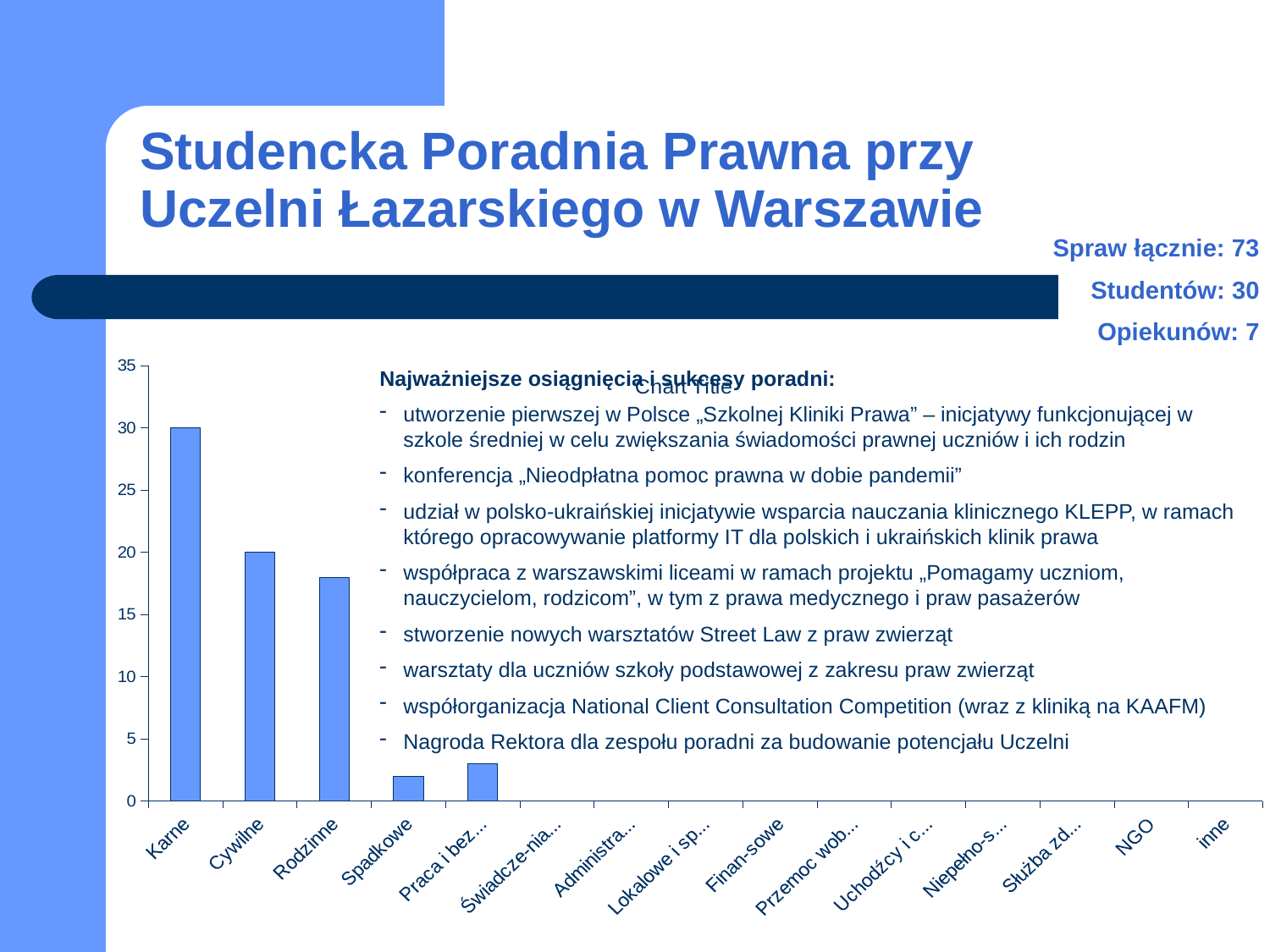
Which is larger in the bar chart, the value for Karne or the value for Cywilne? Karne What is the difference between the values for Karne and Cywilne in the bar chart? 10 What is the value for Cywilne in the bar chart? 20 How many categories are shown on the x axis of the bar chart? 15 What is the value for Karne in the bar chart? 30 Do the bar values generally rise or fall moving from left to right along the x axis? fall Which is larger in the bar chart, the value for Rodzinne or the value for Spadkowe? Rodzinne Is the value for Spadkowe greater or less than 5? less Which category has the highest value in the bar chart? Karne Is the value for Rodzinne greater or less than 20? less What kind of chart is shown on the slide? bar chart Is the value for Rodzinne greater or less than 15? greater